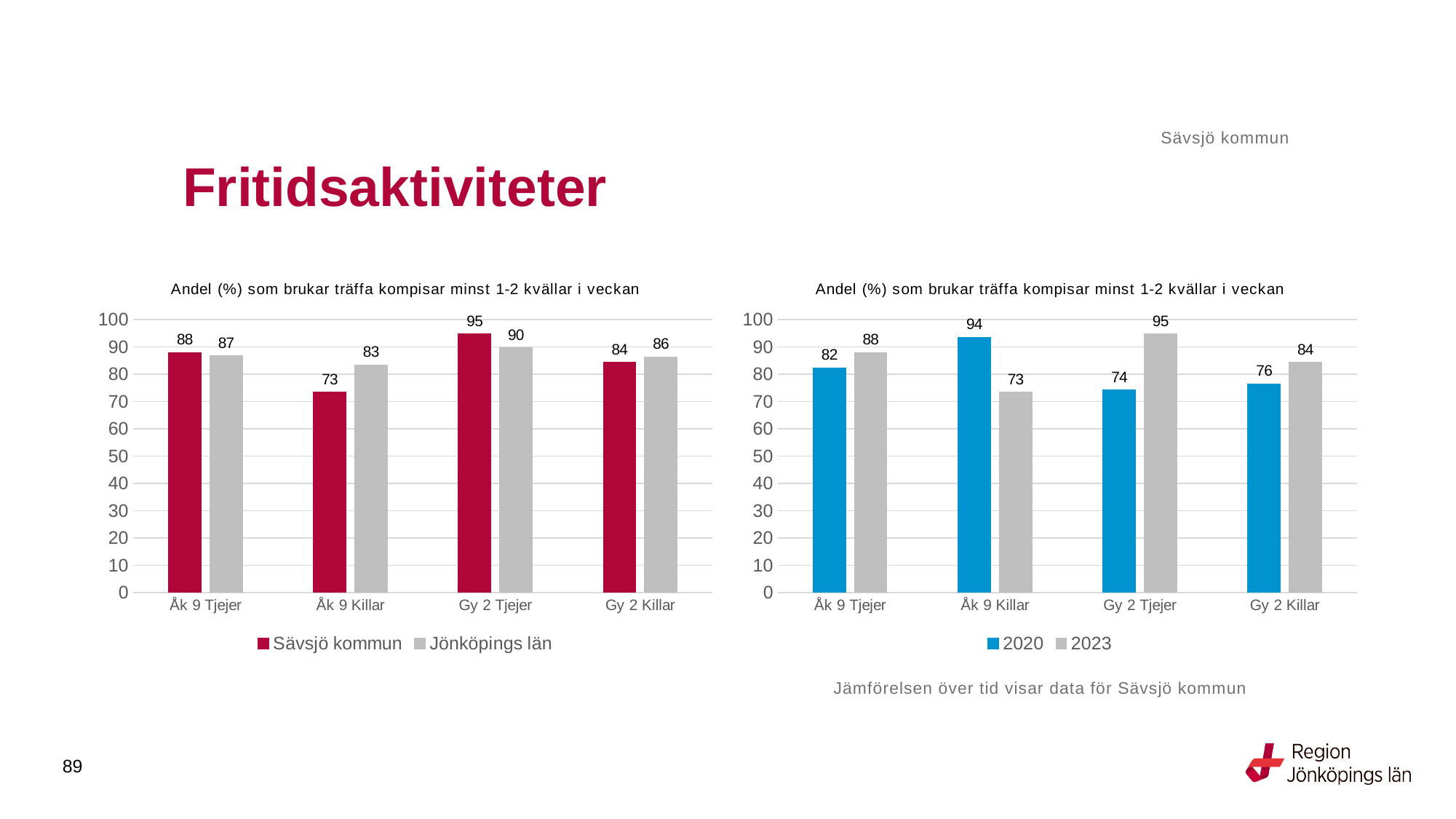
In the right chart, what is the difference between the 2020 and 2023 values for Åk 9 Killar? 21 In the right chart, what are the two legend entries? 2020 and 2023 In the right chart, what is the value for 2023 for Gy 2 Killar? 84 In the left chart, what is the value for Sävsjö kommun for Åk 9 Killar? 73 What type of chart is the right chart? Bar chart In the right chart, how many categories are shown on the x axis? 4 In the left chart, which is larger for Gy 2 Killar: Sävsjö kommun or Jönköpings län? Jönköpings län In the left chart, which category has the highest value for Sävsjö kommun? Gy 2 Tjejer In the left chart, how many series does the legend list? 2 In the right chart, what is the value for 2020 for Åk 9 Killar? 94 In the left chart, what is the value for Jönköpings län for Gy 2 Tjejer? 90 In the right chart, which category has the lowest value for 2020? Gy 2 Tjejer